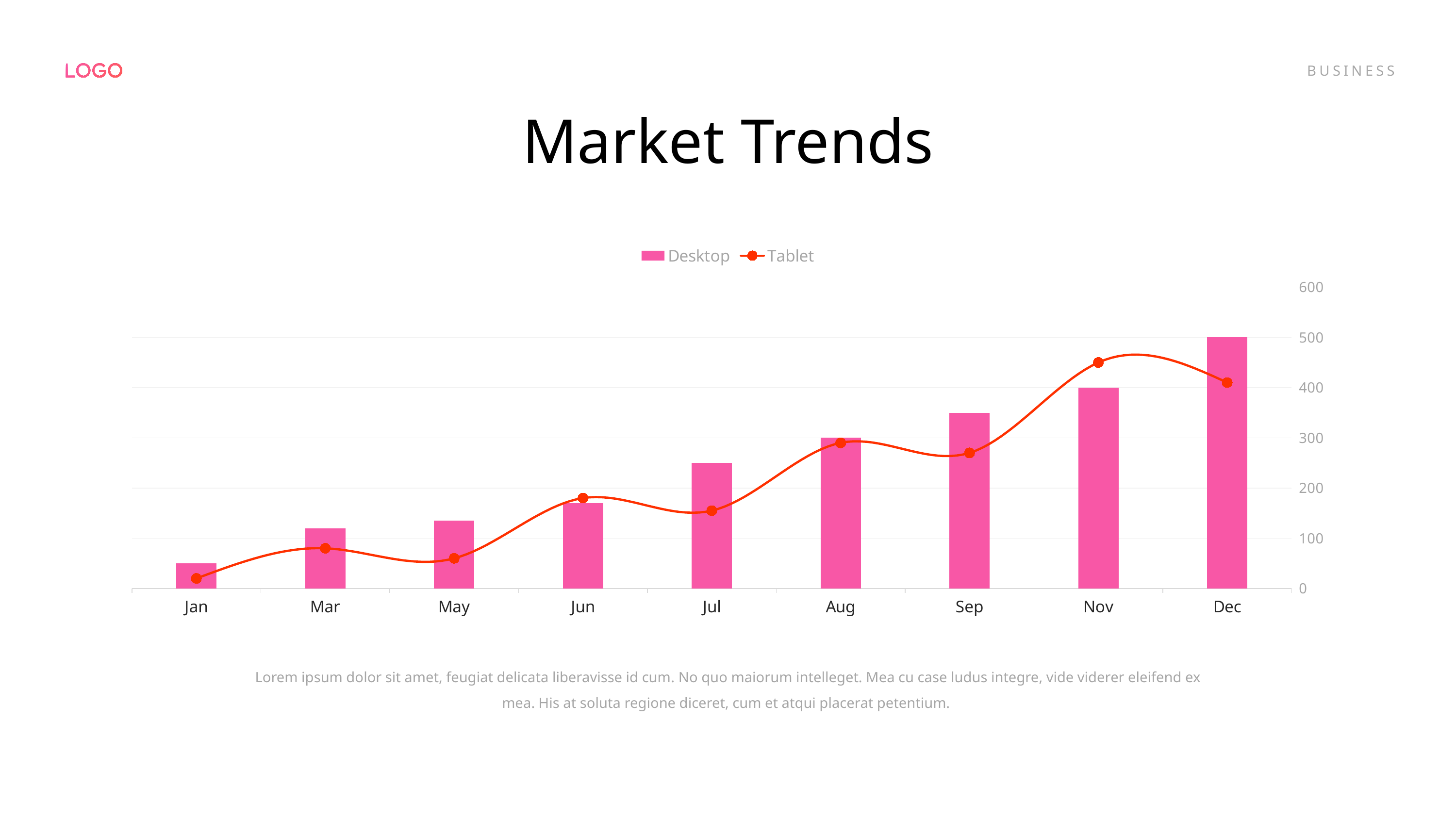
In Dec, which series has the larger value, Desktop or Tablet? Desktop Which month has the highest Tablet value? Nov Which month has the lowest Tablet value? Jan How many series does the legend list? 2 How many months are shown on the x axis? 9 Is the Tablet value for Sep greater or less than 300? less Which month has the lowest Desktop value? Jan Is the Desktop value for Jul greater or less than 200? greater Which month has the highest Desktop value? Dec What kind of chart is shown on the slide? A combined bar and line chart In Nov, which series has the larger value, Desktop or Tablet? Tablet Do the Desktop values generally rise or fall from Jan to Dec? Rise